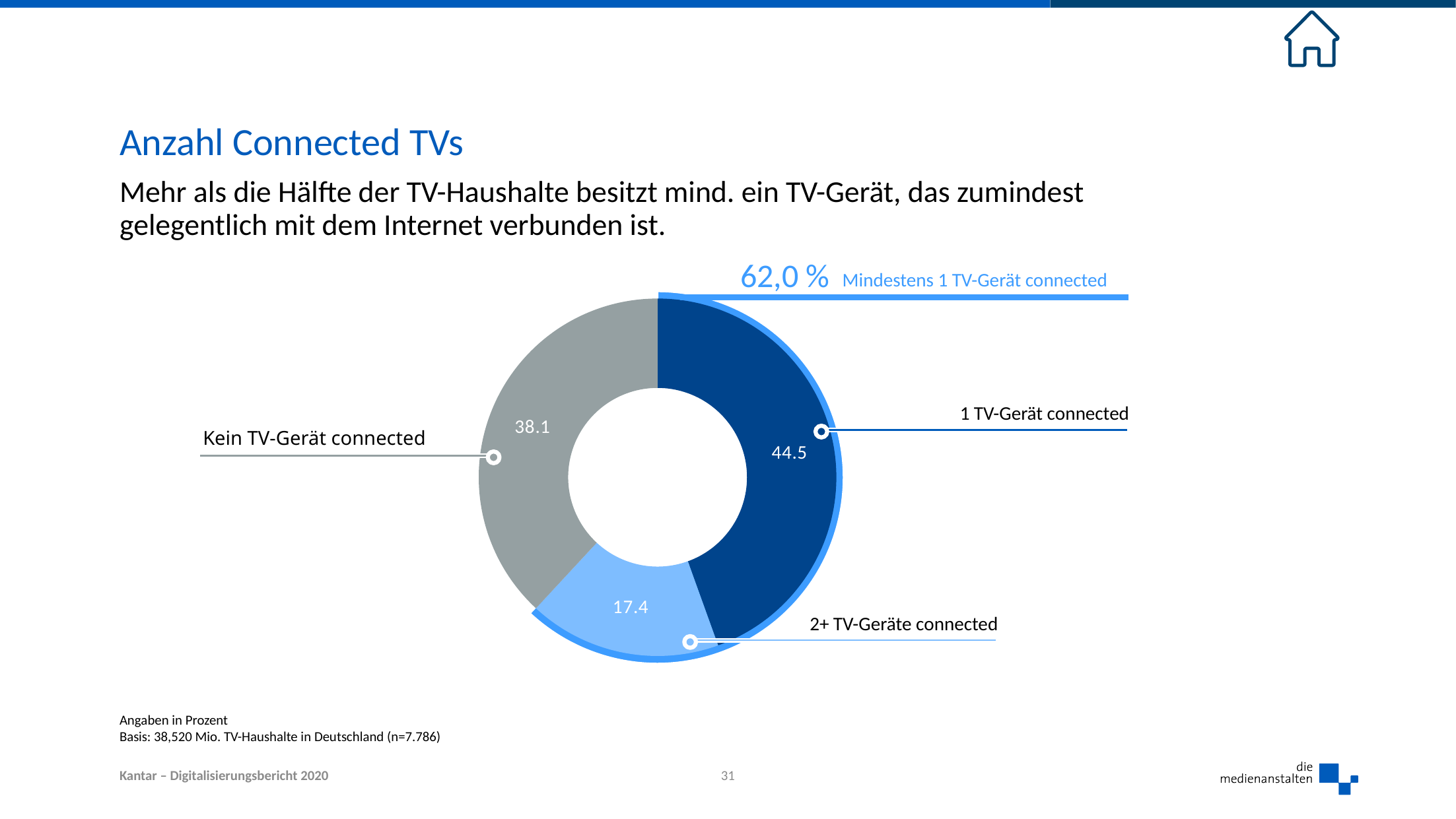
What is the title of the chart slide? Anzahl Connected TVs Which category has the largest share of the chart? 1 TV-Gerät connected What is the difference between the values for "Kein TV-Gerät connected" and "2+ TV-Geräte connected"? 20.7 What is the value for "2+ TV-Geräte connected"? 17.4 What kind of chart is shown on the slide? Donut (pie) chart What is the value for "1 TV-Gerät connected"? 44.5 Which is larger: the value for "Kein TV-Gerät connected" or the value for "2+ TV-Geräte connected"? Kein TV-Gerät connected How many segments does the donut chart have? 3 What is the difference between the values for "1 TV-Gerät connected" and "Kein TV-Gerät connected"? 6.4 What is the value for "Kein TV-Gerät connected"? 38.1 What percentage is given on the slide for "Mindestens 1 TV-Gerät connected"? 62,0 % Which category has the smallest share of the chart? 2+ TV-Geräte connected